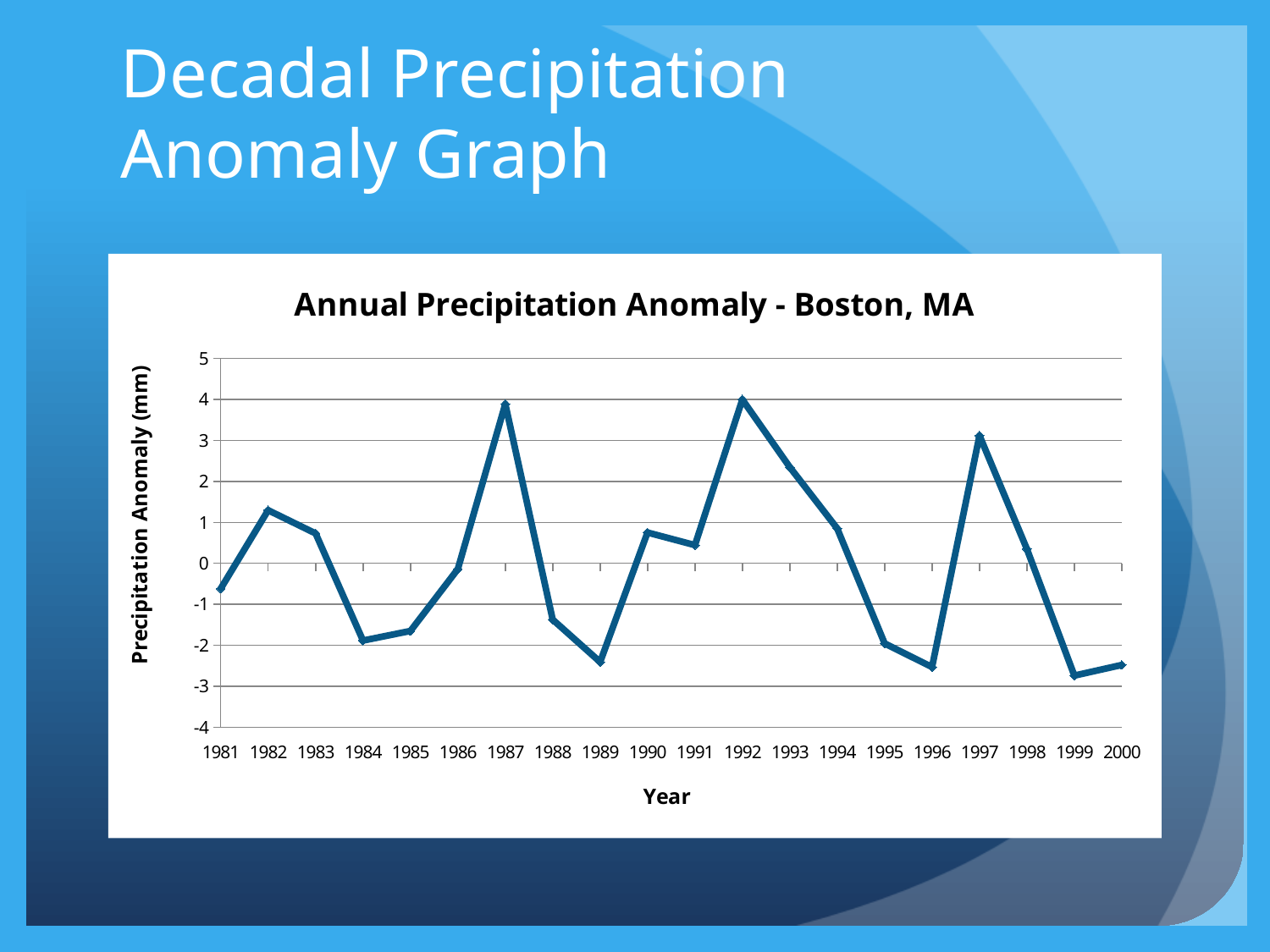
Is the precipitation anomaly for 1989 greater or less than -2? less Is the precipitation anomaly for 1982 greater or less than 1? greater Is the precipitation anomaly for 1987 greater or less than 3? greater What is the title of the chart? Annual Precipitation Anomaly - Boston, MA Does the precipitation anomaly rise or fall from 1992 to 1996? fall How many years are plotted on the x axis of the chart? 20 Which year has the larger precipitation anomaly, 1987 or 1984? 1987 What is the label of the vertical axis? Precipitation Anomaly (mm) Which year has the larger precipitation anomaly, 1997 or 1999? 1997 What kind of chart is shown on the slide? line chart